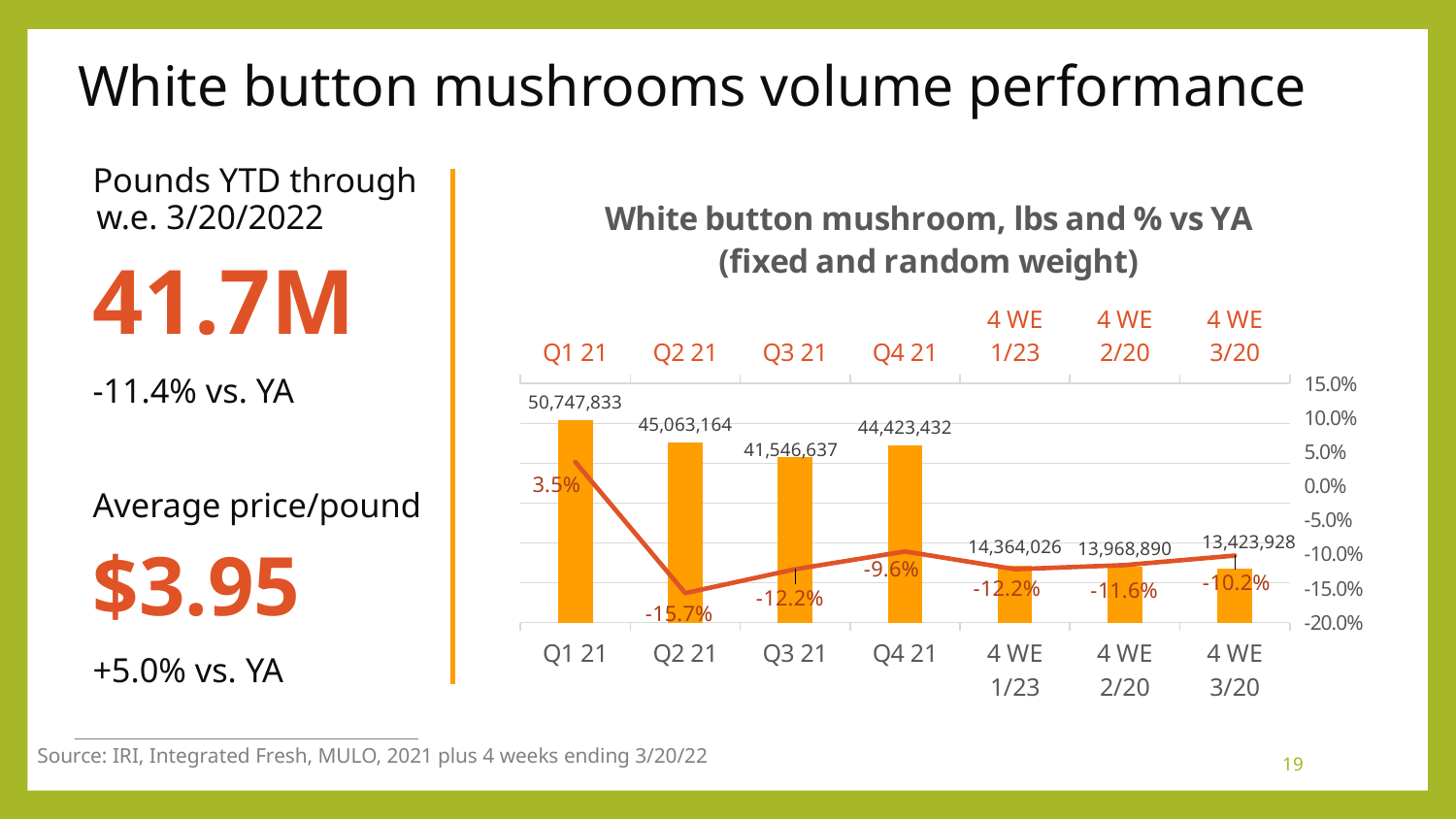
Which period has the lowest % vs YA value? Q2 21 How many periods are shown on the x axis? 7 What kind of chart is this? Combination bar and line chart What is the pounds value for Q1 21? 50,747,833 What is the difference in pounds between Q1 21 and Q2 21? 5,684,669 What is the % vs YA value for Q4 21? -9.6% Which period has the highest pounds value? Q1 21 What is the title of the chart? White button mushroom, lbs and % vs YA (fixed and random weight) What is the % vs YA value for Q2 21? -15.7% Which is larger, the pounds value for Q3 21 or Q4 21? Q4 21 Which period has the lowest pounds value? 4 WE 3/20 What is the pounds value for the 4 WE 3/20 period? 13,423,928